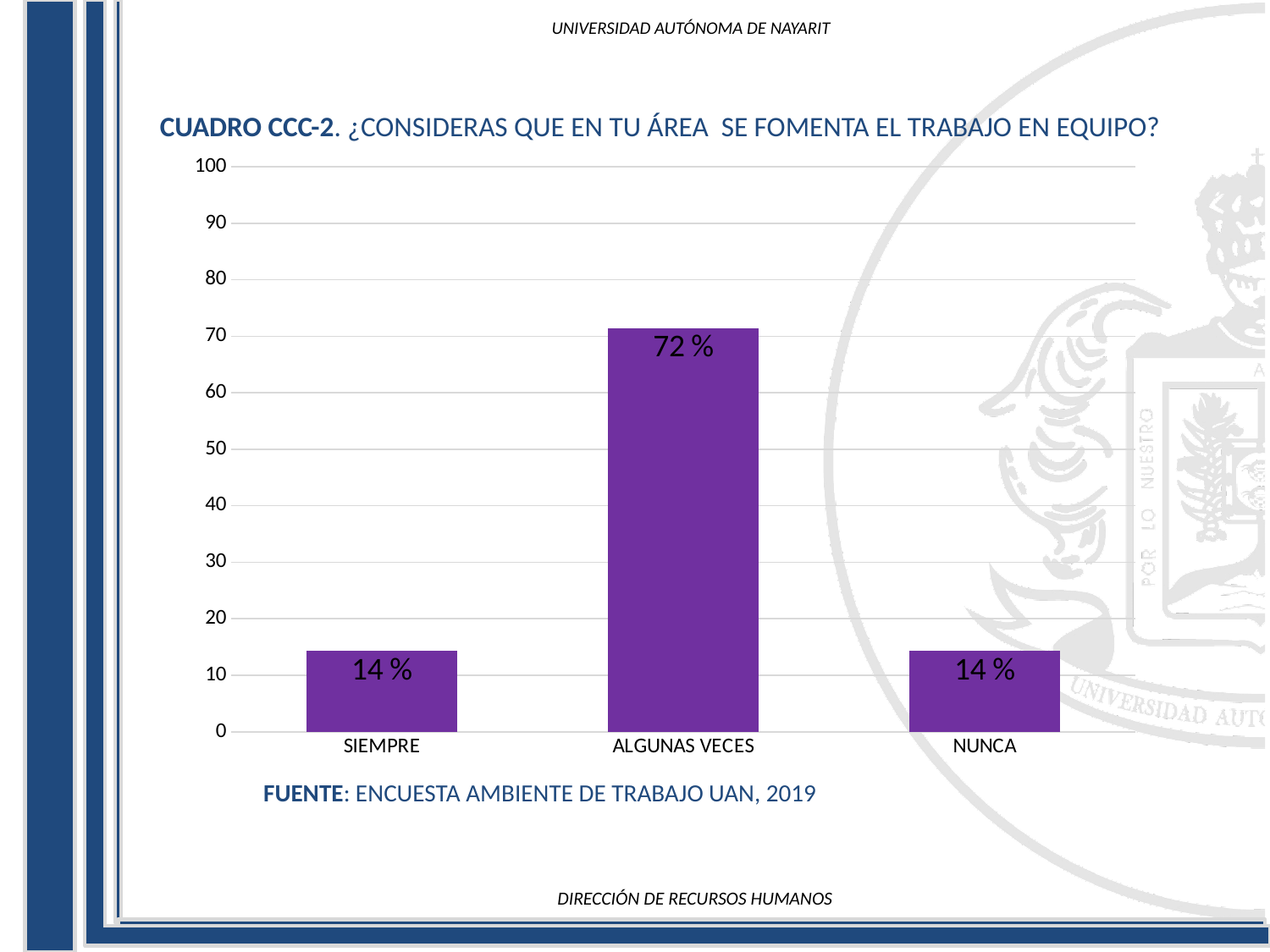
What is the difference between the values for ALGUNAS VECES and SIEMPRE? 58 % Is the value for SIEMPRE greater or less than 20? less What is the value for NUNCA? 14 % Which category has the highest value? ALGUNAS VECES Is the value for ALGUNAS VECES greater or less than 50? greater What is the maximum value shown on the y axis? 100 Which is larger, the value for ALGUNAS VECES or the value for NUNCA? ALGUNAS VECES How many categories are shown on the x axis? 3 What kind of chart is shown on the slide? bar chart What is the source cited below the chart? ENCUESTA AMBIENTE DE TRABAJO UAN, 2019 What is the value for ALGUNAS VECES? 72 % What is the value for SIEMPRE? 14 %